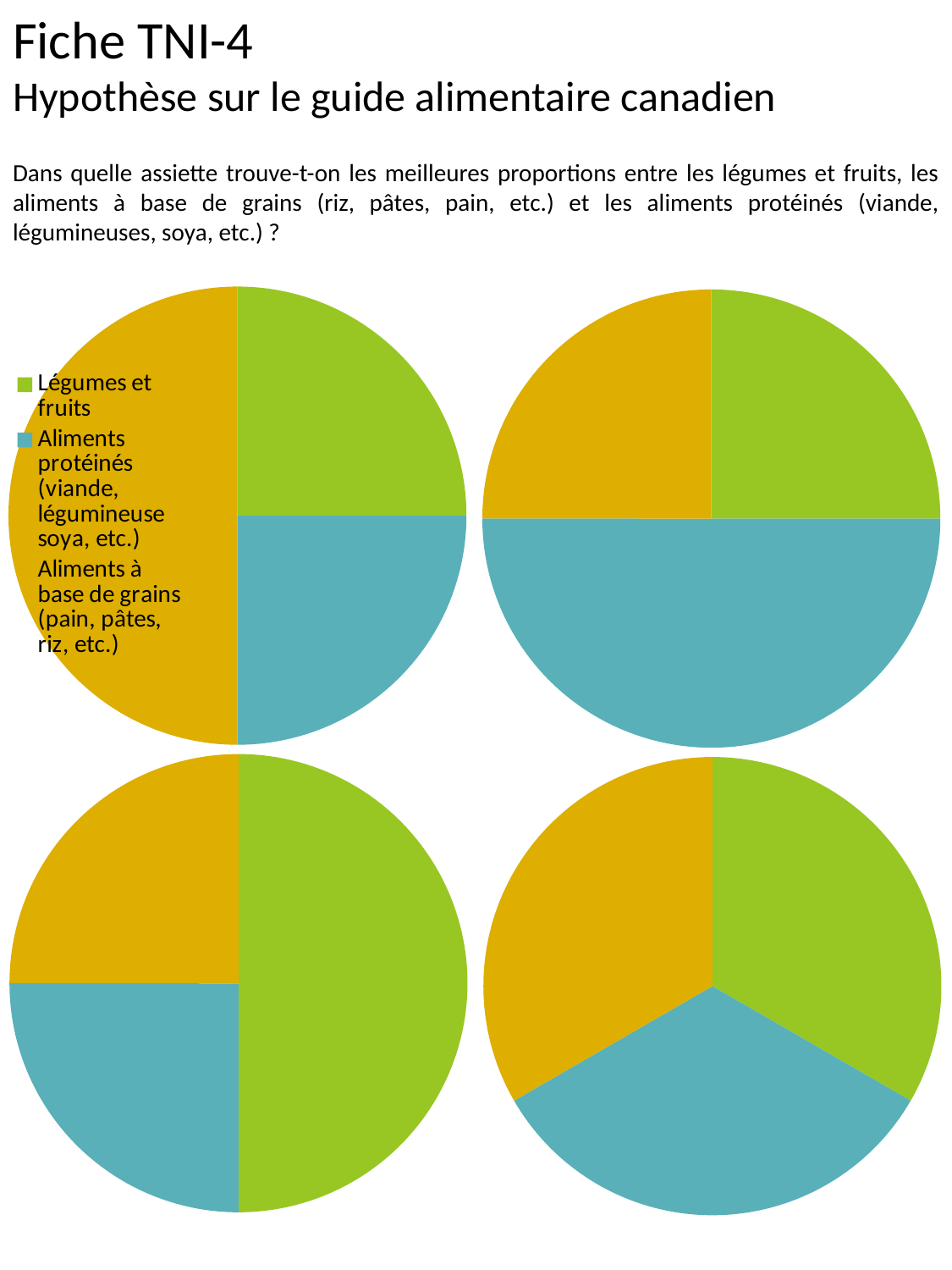
How many pie charts are shown on the slide? 4 In the bottom-left pie chart, which slice is larger: Légumes et fruits or Aliments protéinés? Légumes et fruits In the top-right pie chart, which category has the largest slice? Aliments protéinés (viande, légumineuse soya, etc.) In the bottom-left pie chart, which category has the largest slice? Légumes et fruits How many slices does the bottom-right pie chart have? 3 How many entries does the legend list? 3 In the top-right pie chart, which slice is larger: Aliments protéinés or Légumes et fruits? Aliments protéinés In the top-left pie chart, which slice is larger: Légumes et fruits or Aliments à base de grains? Aliments à base de grains What kind of chart is the top-left chart on the slide? pie chart In the top-left pie chart, which category has the largest slice? Aliments à base de grains (pain, pâtes, riz, etc.) Which colour represents Aliments protéinés in the legend? blue Which colour represents Légumes et fruits in the legend? green